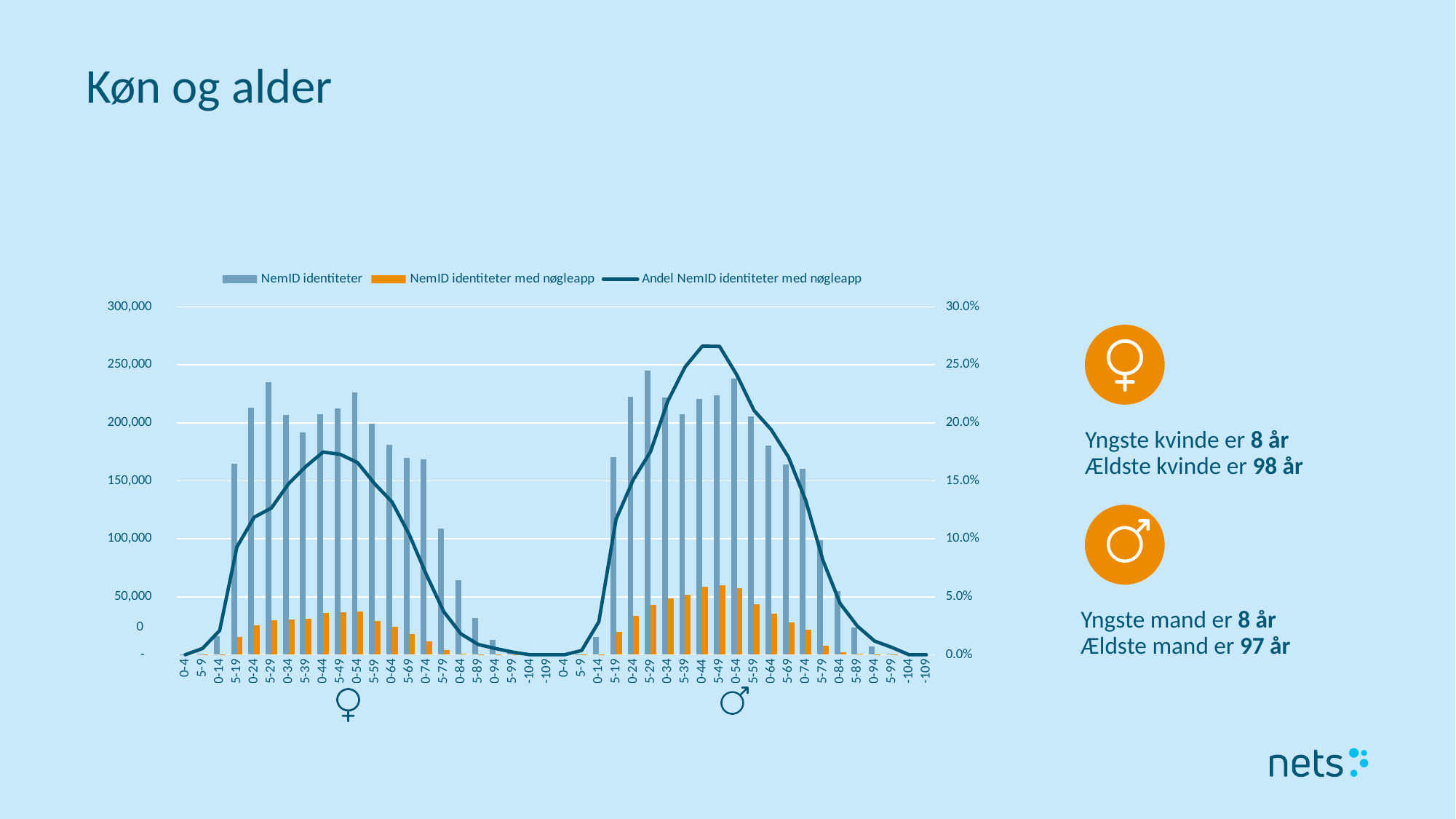
Which gender group reaches the higher peak on the Andel NemID identiteter med nøgleapp line? male Which series in the legend is drawn as a line? Andel NemID identiteter med nøgleapp Is the peak of the Andel NemID identiteter med nøgleapp line in the female group greater or less than 20.0%? less Is the peak of the Andel NemID identiteter med nøgleapp line in the male group greater or less than 25.0%? greater Is the NemID identiteter value for the male age group labelled '5-29' greater or less than 200,000? greater What is the title of the slide containing the chart? Køn og alder What kind of chart is shown on the slide? bar chart with a line In the female group, which is larger: the NemID identiteter bar for '0-14' or for '5-19'? 5-19 In the male group, does the Andel NemID identiteter med nøgleapp line rise or fall from the '5-49' age group to the '5-79' age group? fall How many series does the chart legend list? 3